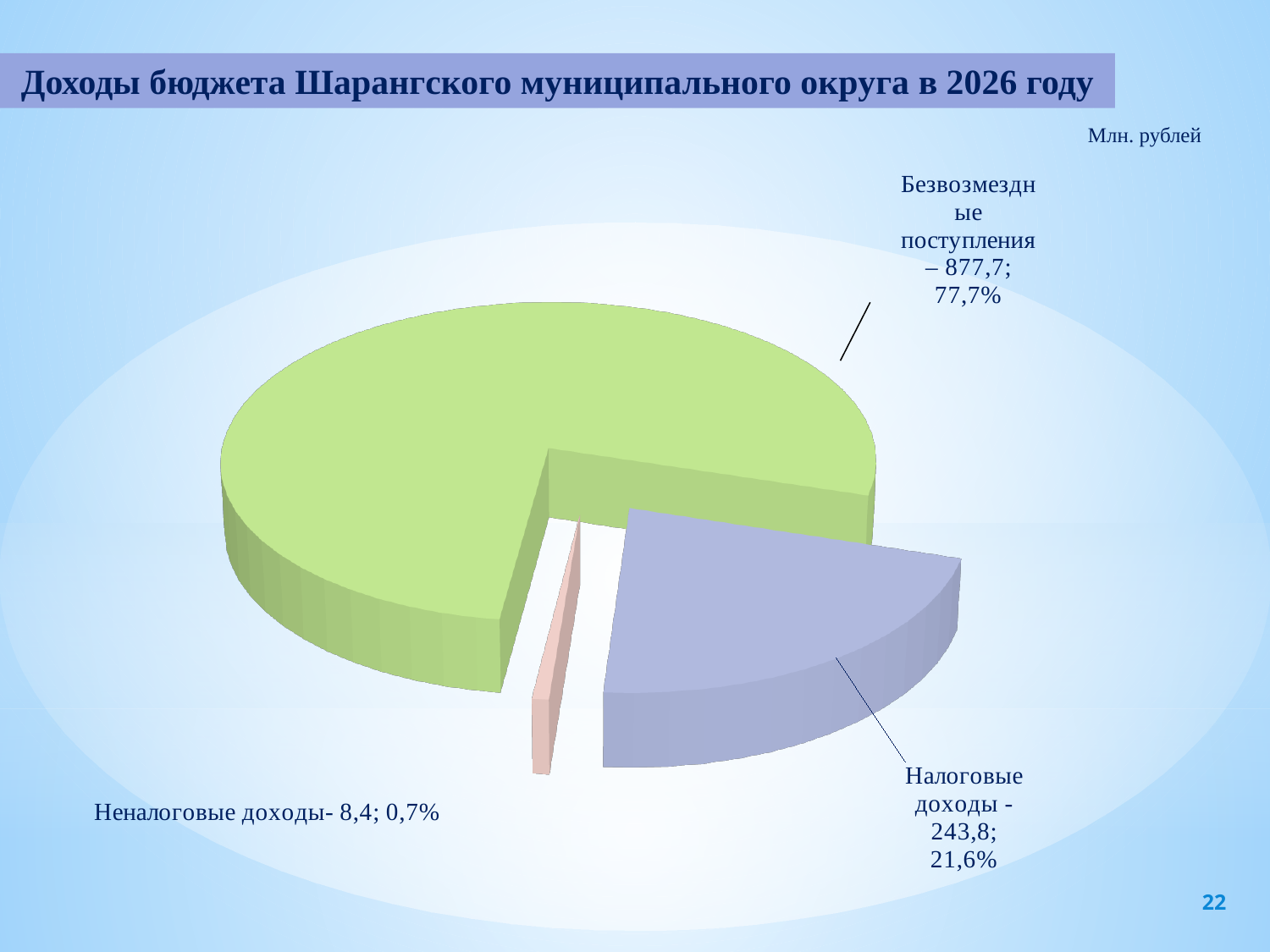
Which category has the smallest slice of the pie? Неналоговые доходы In what units are the values on the chart given? Млн. рублей What is the value for Налоговые доходы? 243,8 What share of the pie does Неналоговые доходы represent? 0,7% What is the value for Безвозмездные поступления? 877,7 What share of the pie does Налоговые доходы represent? 21,6% How many slices does the pie chart have? 3 What is the difference between the values for Безвозмездные поступления and Налоговые доходы? 633,9 Which category has the largest slice of the pie? Безвозмездные поступления What type of chart is shown on the slide? pie chart What is the value for Неналоговые доходы? 8,4 What share of the pie does Безвозмездные поступления represent? 77,7%